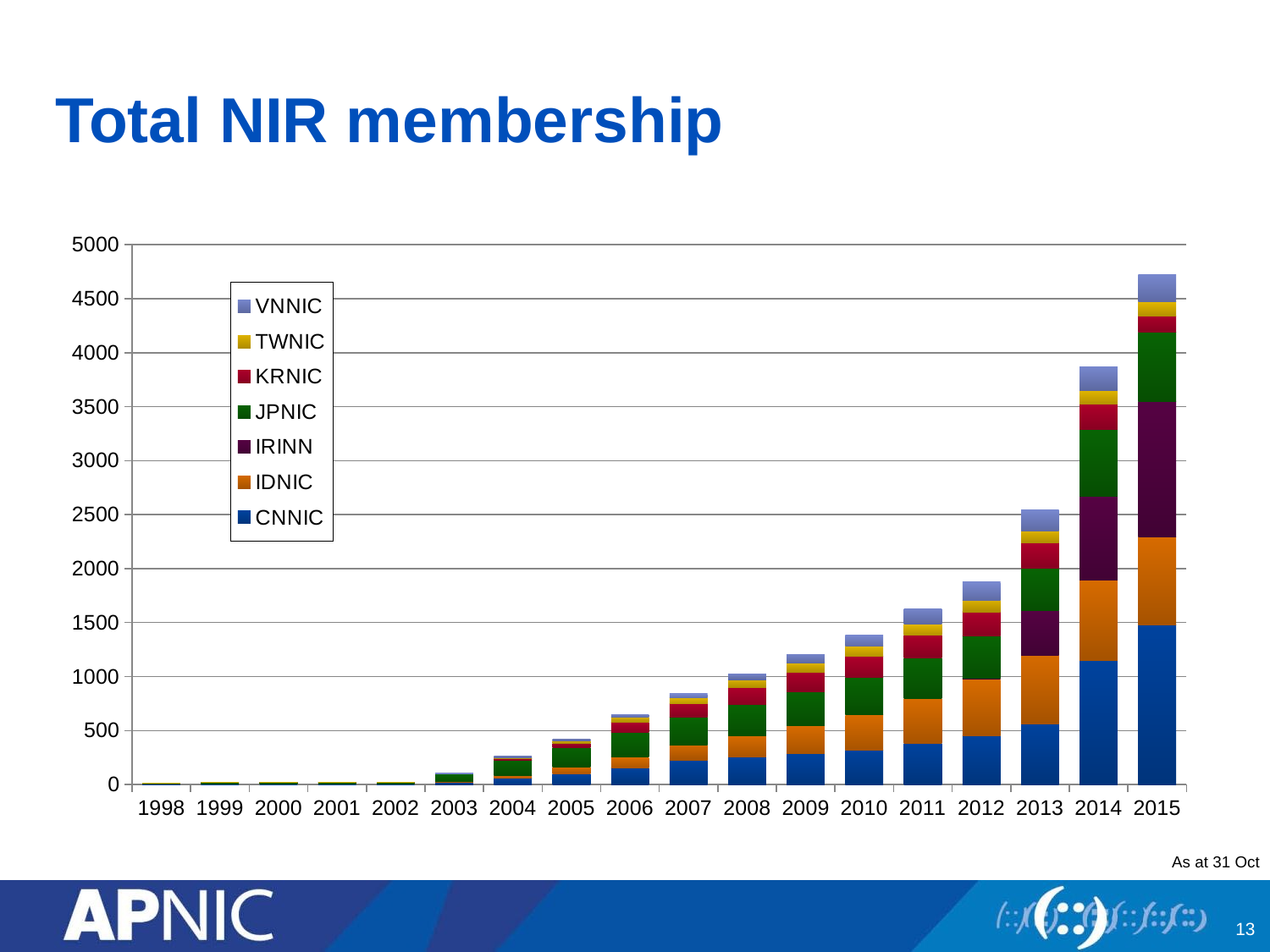
Is the total membership for 2007 greater or less than 1000? less What kind of chart is shown on the slide? Stacked bar chart Is the total membership for 2015 greater or less than 4000? greater How many series does the chart's legend list? 7 Which year has the larger total membership, 2013 or 2014? 2014 Which series is listed first (at the top) in the chart's legend? VNNIC Is the total membership for 2014 greater or less than 3500? greater How many years are shown along the x axis of the chart? 18 Which year has the highest total NIR membership? 2015 Do the total membership values rise or fall from 1998 to 2015? Rise